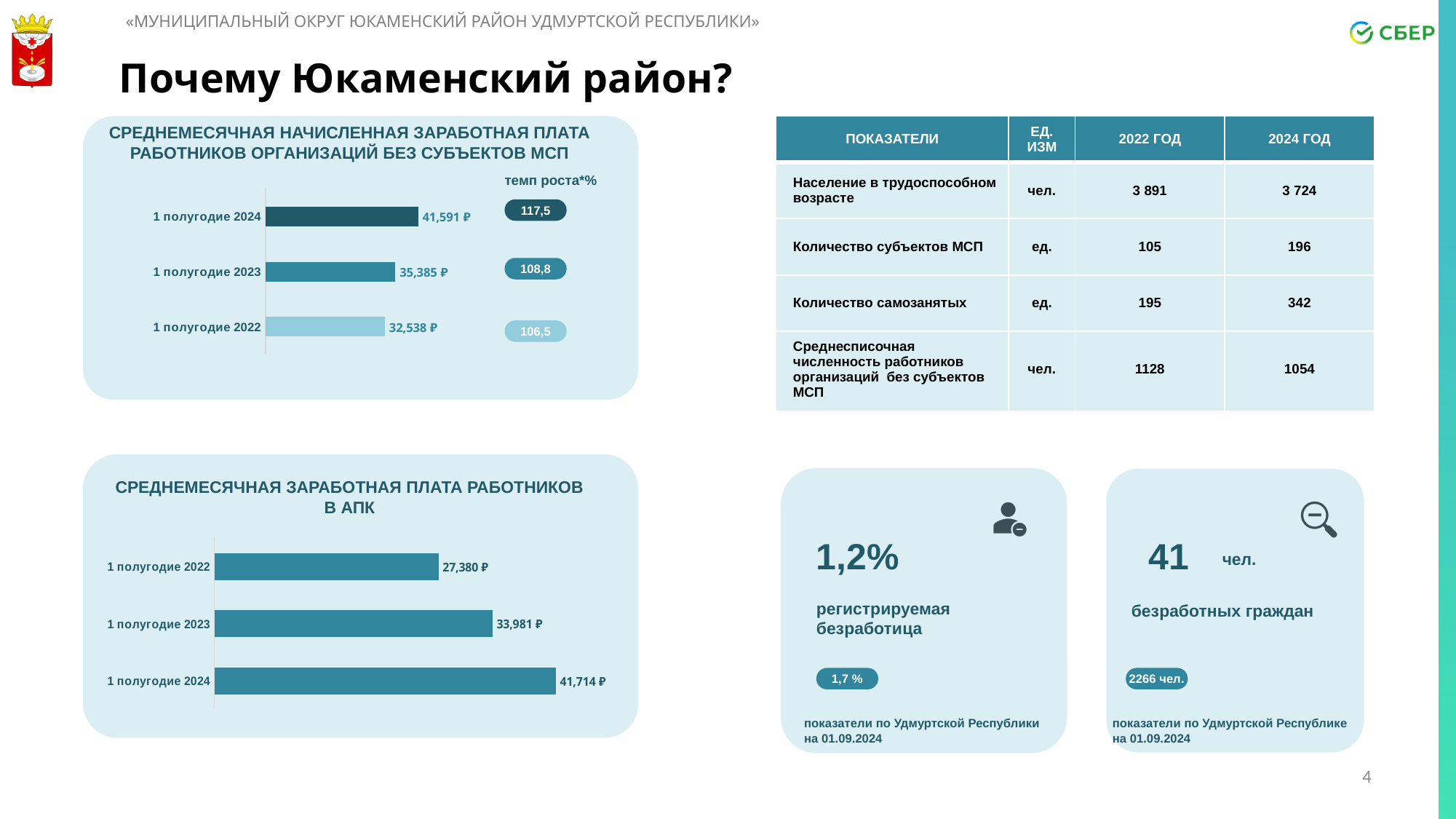
In the bottom-left chart (wages in АПК), what is the difference between the values for 1 полугодие 2024 and 1 полугодие 2022? 14,334 ₽ In the top-left chart (wages excluding SMEs), which period has the lowest value? 1 полугодие 2022 In the bottom-left chart (wages in АПК), which is larger: the value for 1 полугодие 2022 or 1 полугодие 2023? 1 полугодие 2023 In the top-left chart (wages excluding SMEs), what growth rate (темп роста) is shown next to 1 полугодие 2023? 108,8 In the bottom-left chart (average monthly wages of workers in АПК), what is the value for 1 полугодие 2023? 33,981 ₽ In the top-left chart (wages excluding SMEs), what is the value for 1 полугодие 2022? 32,538 ₽ In the top-left chart (wages excluding SMEs), what is the difference between the values for 1 полугодие 2024 and 1 полугодие 2023? 6,206 ₽ How many bars are shown in the bottom-left chart (wages in АПК)? 3 In the bottom-left chart (wages in АПК), do the values rise or fall from 1 полугодие 2022 to 1 полугодие 2024? Rise What type of chart is the top-left chart (wages excluding SMEs)? Bar chart In the top-left chart (average monthly accrued wages of employees of organizations excluding SMEs), what is the value for 1 полугодие 2024? 41,591 ₽ In the bottom-left chart (wages in АПК), which period has the highest value? 1 полугодие 2024